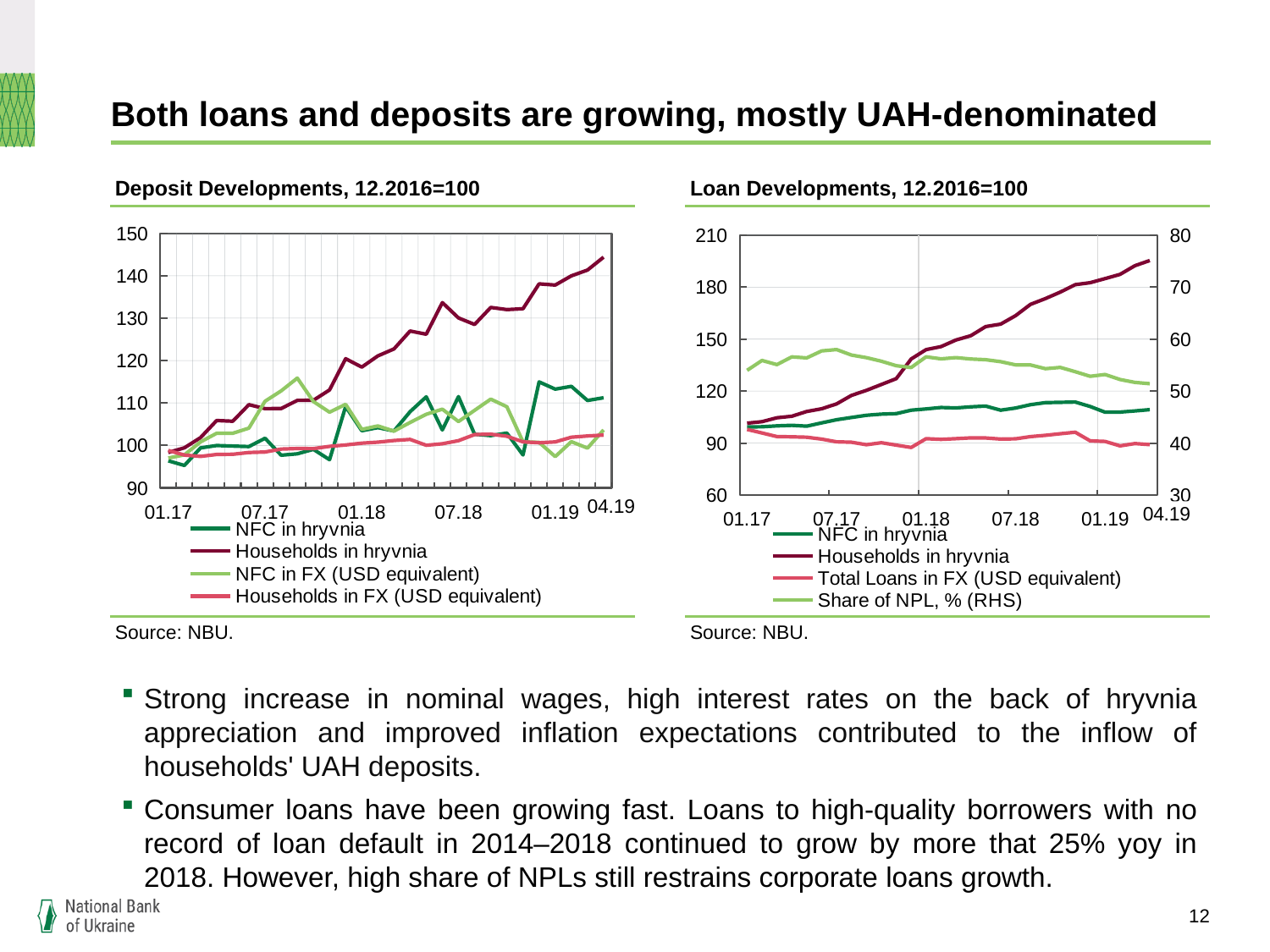
How many series does the legend of the 'Deposit Developments, 12.2016=100' chart list? 4 In the 'Deposit Developments, 12.2016=100' chart, is the value for Households in hryvnia at 04.19 greater or less than 140? greater In the 'Loan Developments, 12.2016=100' chart, is the Share of NPL, % (RHS) at 04.19 greater or less than 60 on the right-hand axis? less How many series does the legend of the 'Loan Developments, 12.2016=100' chart list? 4 What is the title of the chart on the left of the slide? Deposit Developments, 12.2016=100 In the 'Deposit Developments, 12.2016=100' chart, which is larger at 04.19: NFC in hryvnia or Households in hryvnia? Households in hryvnia In the 'Deposit Developments, 12.2016=100' chart, which series is highest at 04.19? Households in hryvnia What kind of chart is the 'Deposit Developments, 12.2016=100' chart? line chart In the 'Loan Developments, 12.2016=100' chart, does the Households in hryvnia series rise or fall from 01.17 to 04.19? rise In the 'Loan Developments, 12.2016=100' chart, is the value for Households in hryvnia at 04.19 greater or less than 180? greater In the 'Loan Developments, 12.2016=100' chart, which series is plotted on the right-hand axis? Share of NPL, % (RHS)